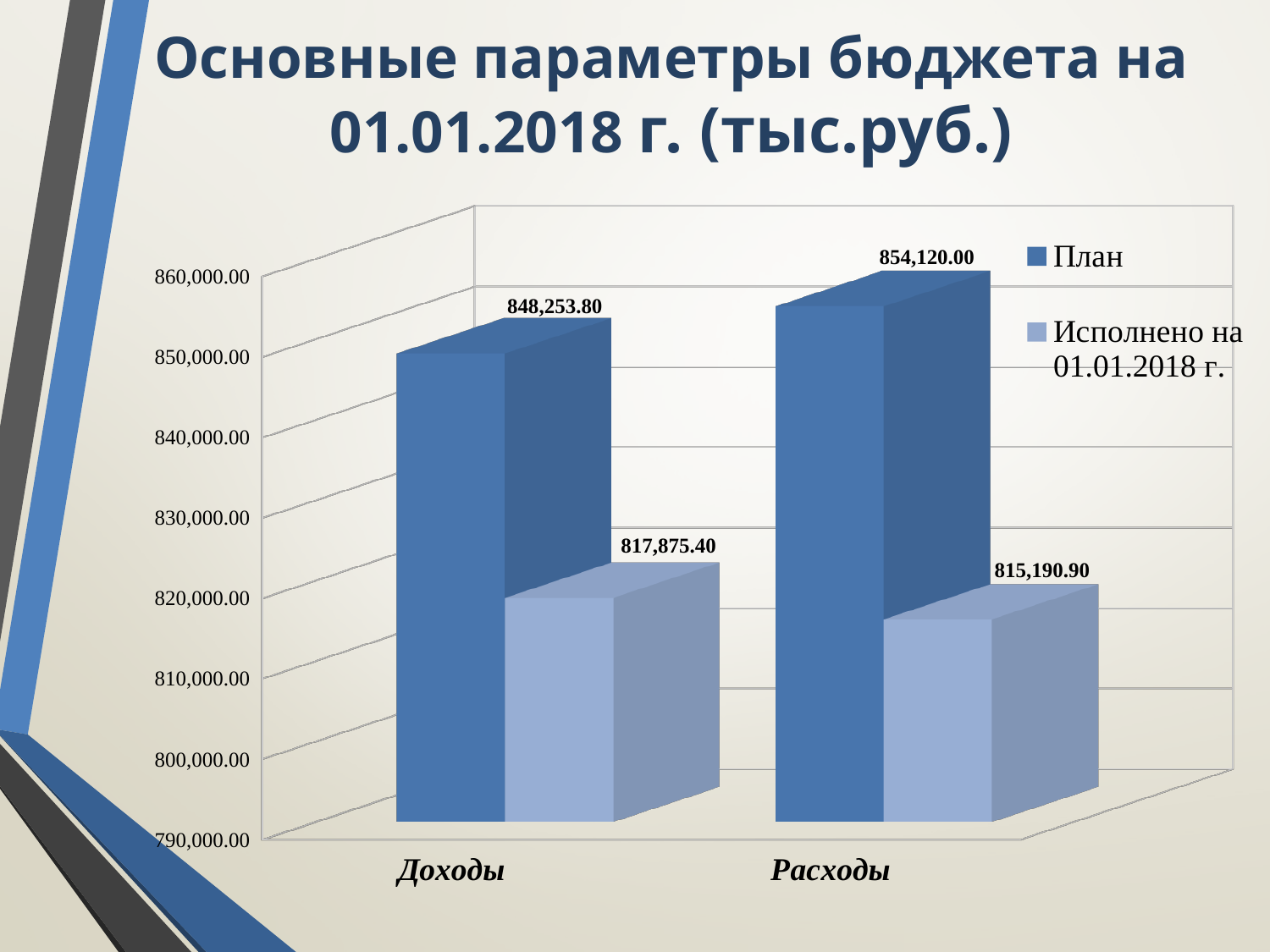
Which is larger: the План value for Доходы or the План value for Расходы? План for Расходы What kind of chart is shown on the slide? Bar chart What is the difference between the План and Исполнено на 01.01.2018 г. values for Расходы? 38,929.10 Which bar has the highest value on the chart? План for Расходы How many series does the legend list? 2 What is the difference between the План and Исполнено на 01.01.2018 г. values for Доходы? 30,378.40 Which bar has the lowest value on the chart? Исполнено на 01.01.2018 г. for Расходы What is the План value for Расходы? 854,120.00 What is the Исполнено на 01.01.2018 г. value for Расходы? 815,190.90 How many categories are shown on the x axis? 2 What is the План value for Доходы? 848,253.80 What is the Исполнено на 01.01.2018 г. value for Доходы? 817,875.40